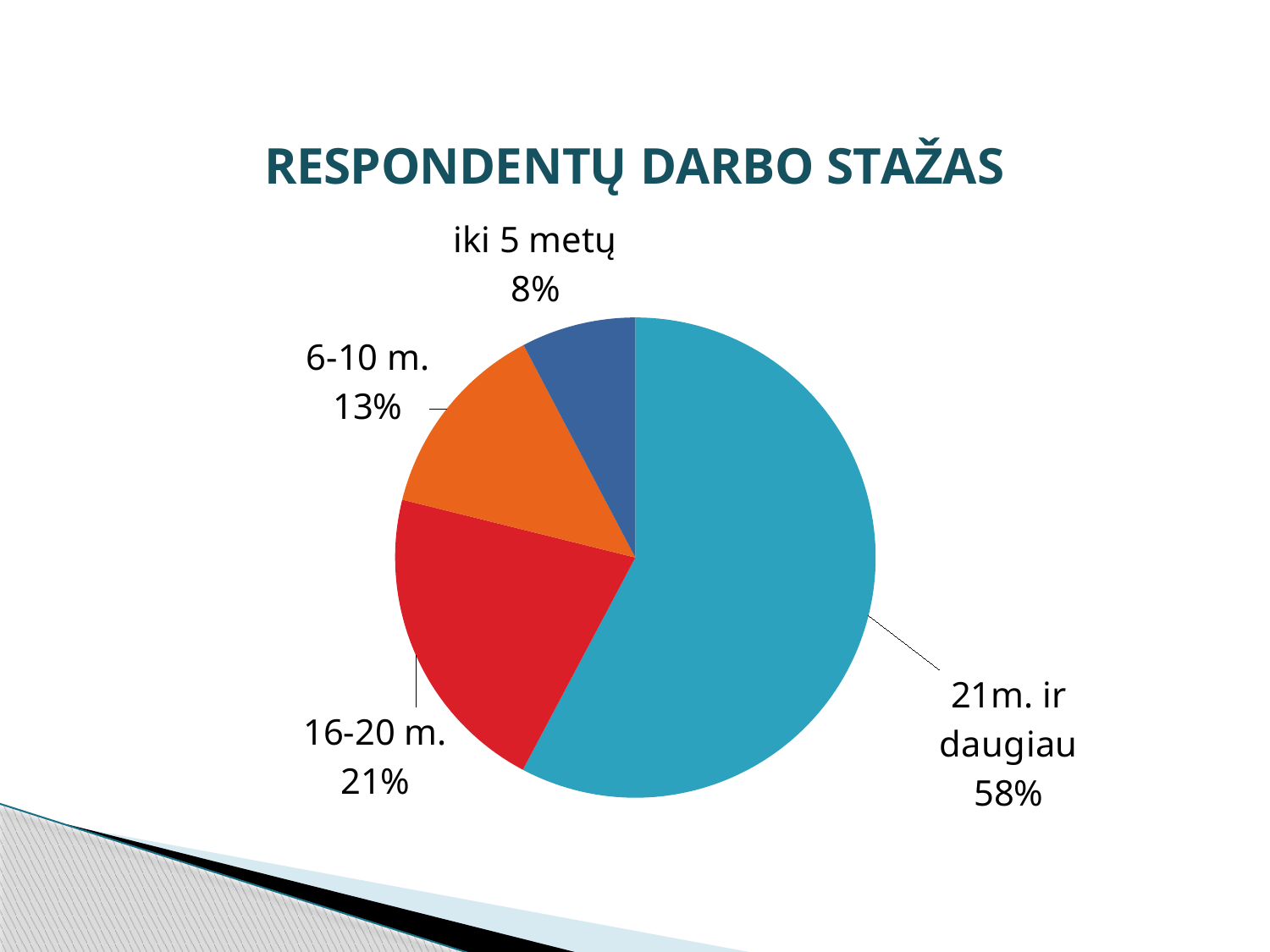
What type of chart is shown on the slide? pie chart What share of respondents have a work experience of 'iki 5 metų'? 8% What share of respondents have a work experience of '6-10 m.'? 13% Which is larger, the share for '6-10 m.' or the share for 'iki 5 metų'? 6-10 m. Which category has the largest slice of the pie? 21m. ir daugiau What is the title of the chart? RESPONDENTŲ DARBO STAŽAS What share of respondents have a work experience of '21m. ir daugiau'? 58% What colour is the slice for '16-20 m.'? red Which category has the smallest slice of the pie? iki 5 metų How many categories are shown in the pie chart? 4 What is the difference in percentage points between '21m. ir daugiau' and '16-20 m.'? 37